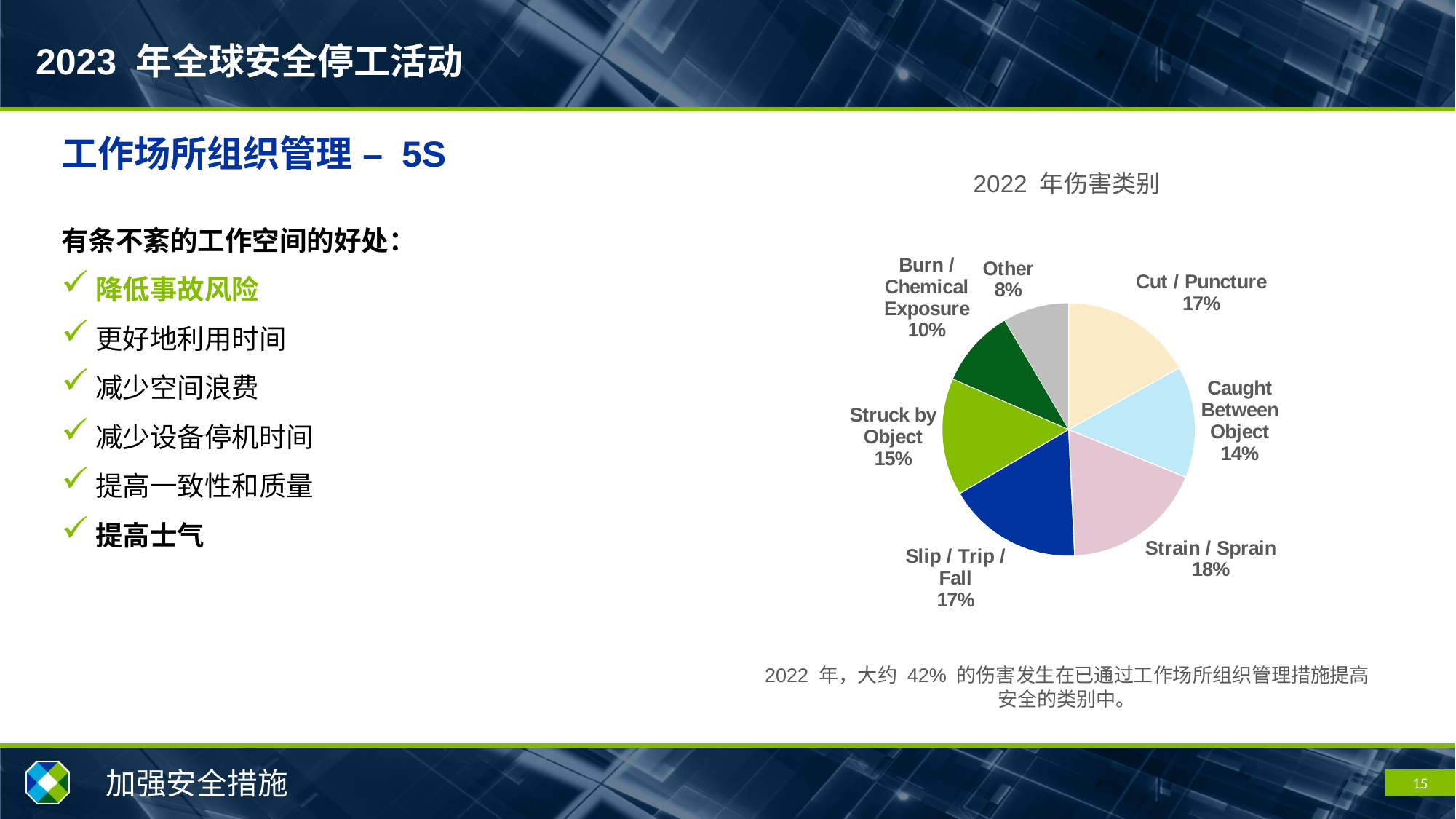
Which injury category has the smallest share? Other What kind of chart is shown on the slide? pie chart Which has a larger share, Struck by Object or Caught Between Object? Struck by Object What is the title of the pie chart? 2022 年伤害类别 Which injury category has the largest share? Strain / Sprain What share of injuries is attributed to Burn / Chemical Exposure? 10% What is the combined share of Cut / Puncture and Slip / Trip / Fall? 34% What is the difference in share between Strain / Sprain and Other? 10% What share of injuries is attributed to Strain / Sprain? 18% What colour is the Slip / Trip / Fall slice? dark blue How many injury categories are shown in the pie chart? 7 What share of injuries is attributed to Caught Between Object? 14%